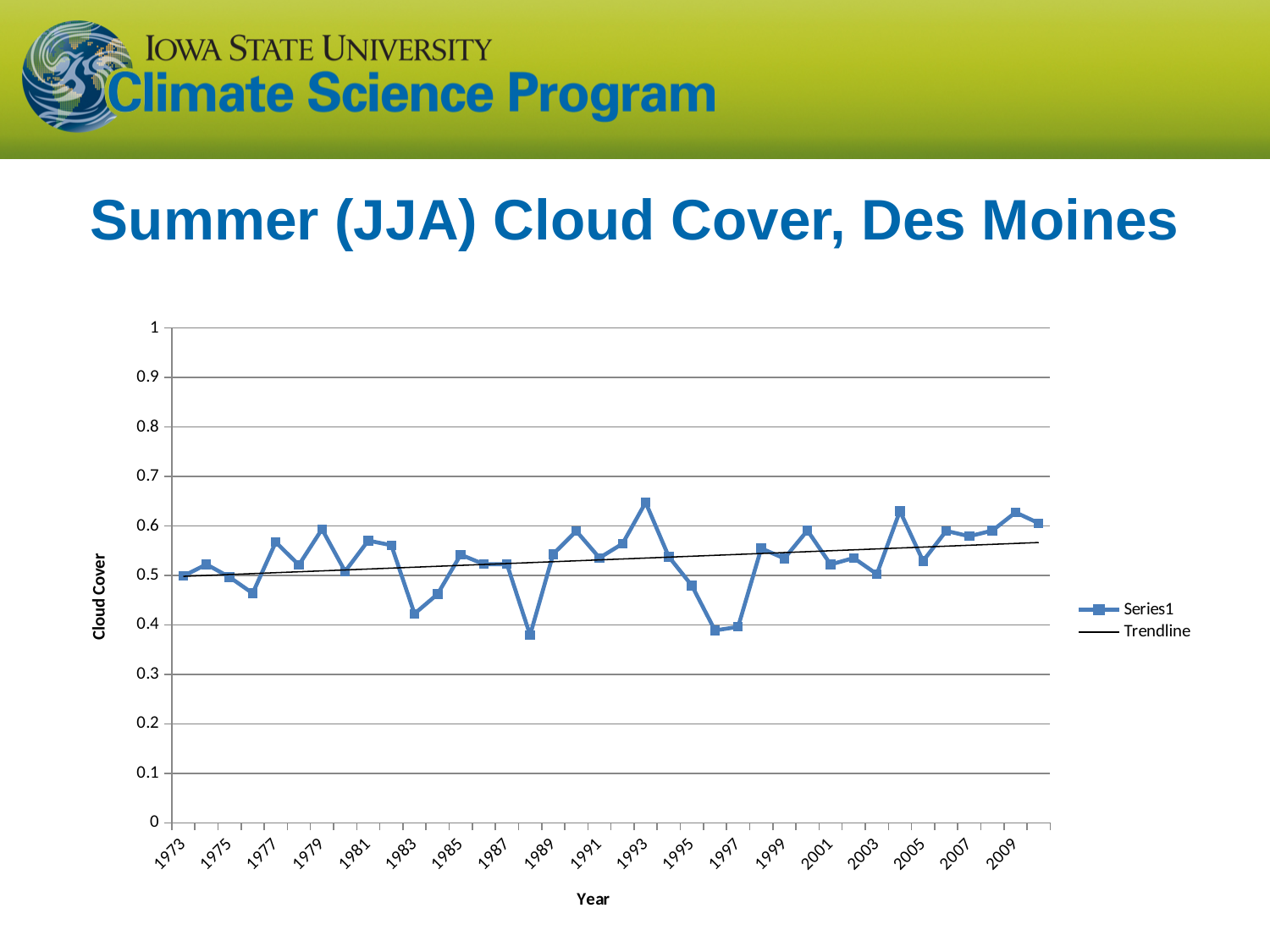
What are the two entries listed in the legend? Series1 and Trendline In which year does Series1 reach its lowest cloud cover value? 1988 Which year has the larger Series1 value, 1996 or 2000? 2000 Is the Series1 value for 1983 greater or less than 0.5? less What is the title of the vertical axis? Cloud Cover What kind of chart is shown on the slide? line chart Is the Series1 value for 1993 greater or less than 0.6? greater Does the trendline rise or fall from 1973 to 2010? rises Is the Series1 value for 1988 greater or less than 0.4? less How many series does the legend list? 2 In which year does Series1 reach its highest cloud cover value? 1993